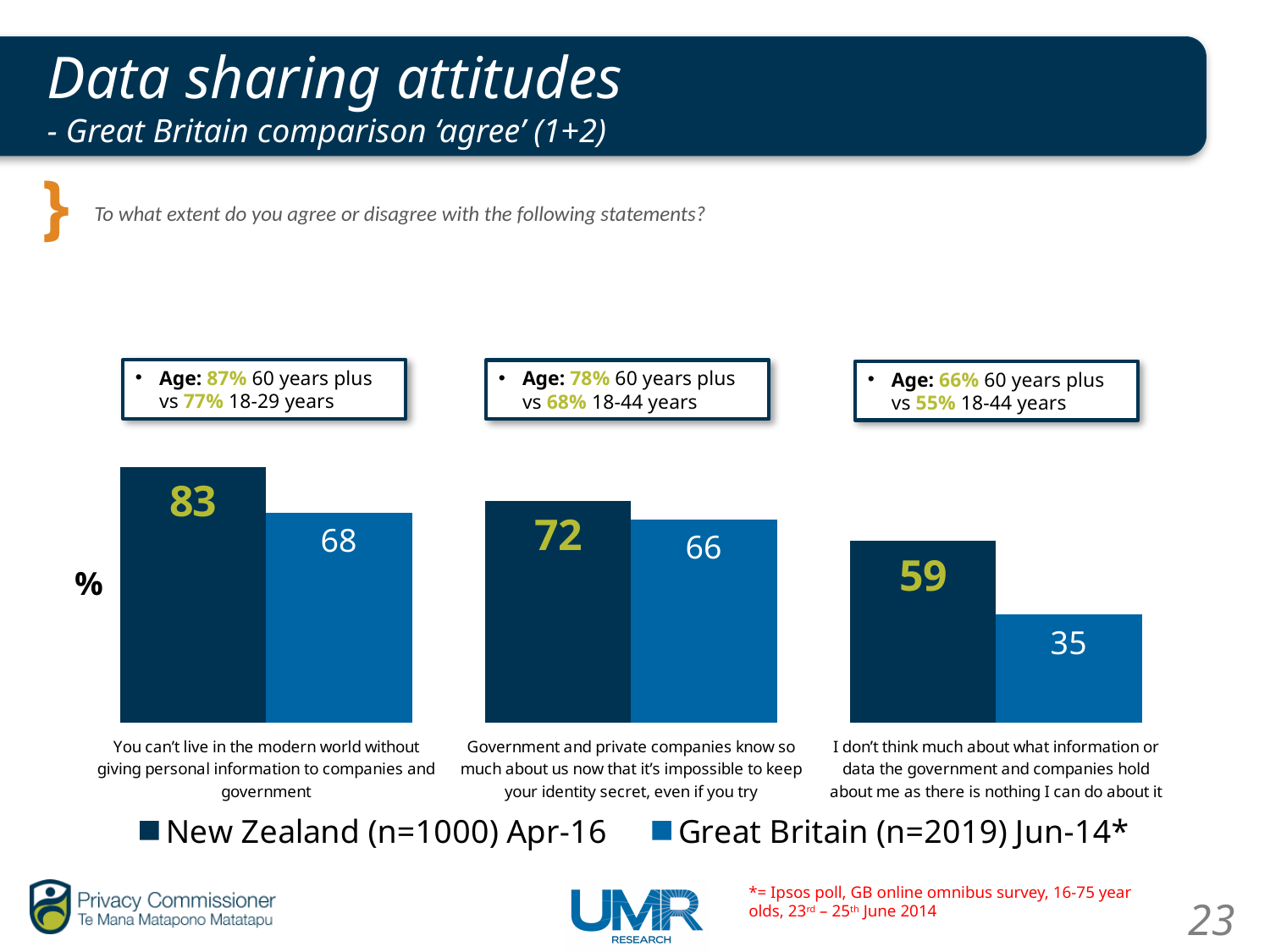
What are the two series named in the legend? New Zealand (n=1000) Apr-16 and Great Britain (n=2019) Jun-14* What is the New Zealand value for the statement 'You can't live in the modern world without giving personal information to companies and government'? 83 What kind of chart is shown on the slide? Bar chart What is the Great Britain value for the statement 'I don't think much about what information or data the government and companies hold about me as there is nothing I can do about it'? 35 What is the difference between the New Zealand and Great Britain values for the statement 'I don't think much about what information or data the government and companies hold about me as there is nothing I can do about it'? 24 What is the difference between the New Zealand and Great Britain values for the statement 'You can't live in the modern world without giving personal information to companies and government'? 15 Which statement has the highest New Zealand value? You can't live in the modern world without giving personal information to companies and government Which statement has the lowest Great Britain value? I don't think much about what information or data the government and companies hold about me as there is nothing I can do about it How many statements are shown on the chart? 3 For the statement 'Government and private companies know so much about us now that it's impossible to keep your identity secret, even if you try', which is larger: the New Zealand value or the Great Britain value? New Zealand How many series does the legend list? 2 What is the Great Britain value for the statement 'Government and private companies know so much about us now that it's impossible to keep your identity secret, even if you try'? 66